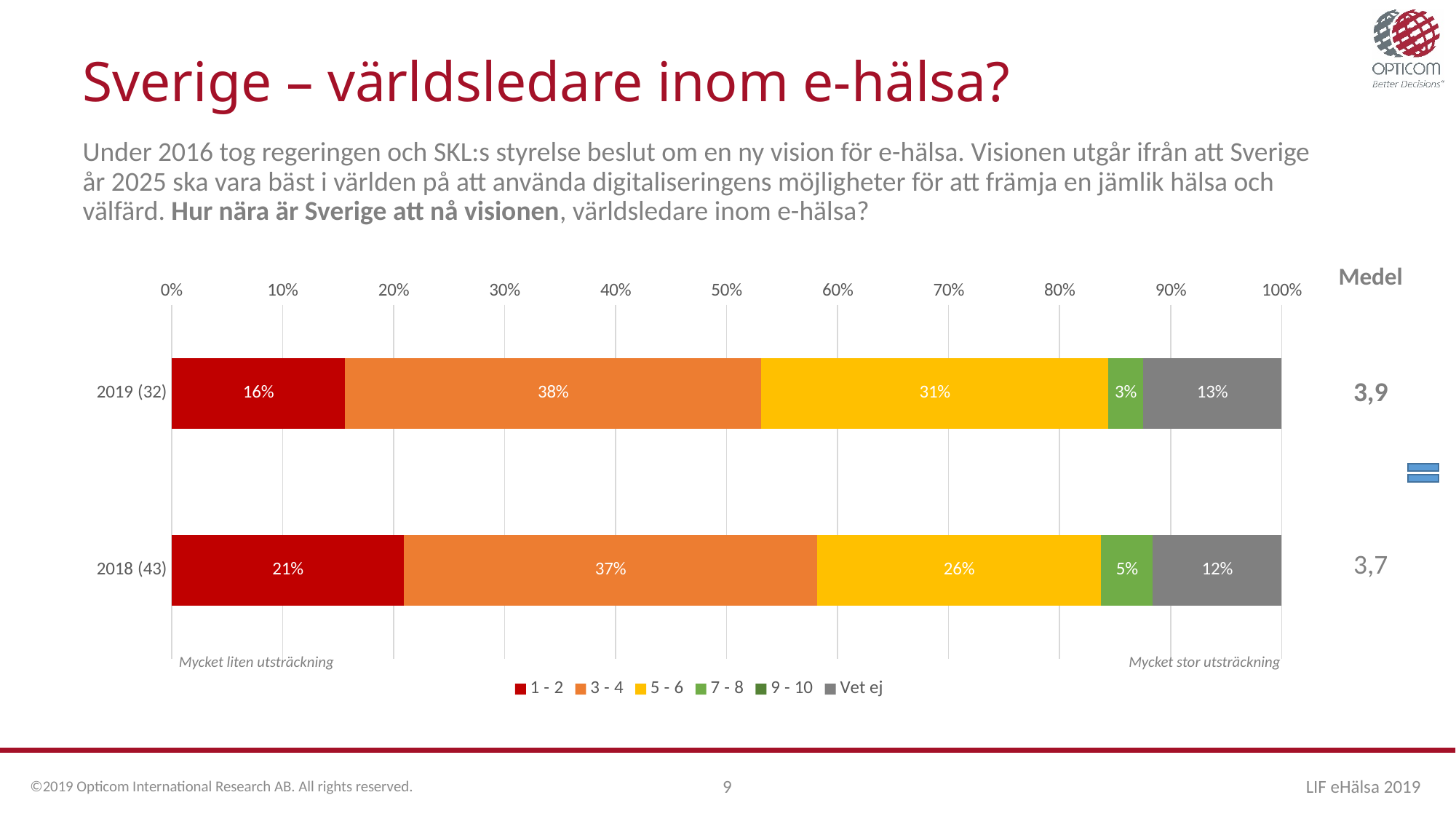
How many series does the legend list? 6 What is the 'Vet ej' share for 2019 (32)? 13% What is the difference between the 5 - 6 share in 2019 (32) and in 2018 (43)? 5 percentage points What label appears at the right end of the x axis below the chart? Mycket stor utsträckning Which year has the larger share of 1 - 2 answers, 2019 (32) or 2018 (43)? 2018 (43) How many bars (years) are shown in the chart? 2 What kind of chart is shown on the slide? Stacked bar chart What percentage of respondents in 2019 (32) answered 1 - 2? 16% Which labelled answer category has the smallest share in the 2018 (43) bar? 7 - 8 What is the 'Medel' value shown for 2018 (43)? 3,7 Which answer category has the largest share in the 2019 (32) bar? 3 - 4 What percentage of respondents in 2018 (43) answered 3 - 4? 37%